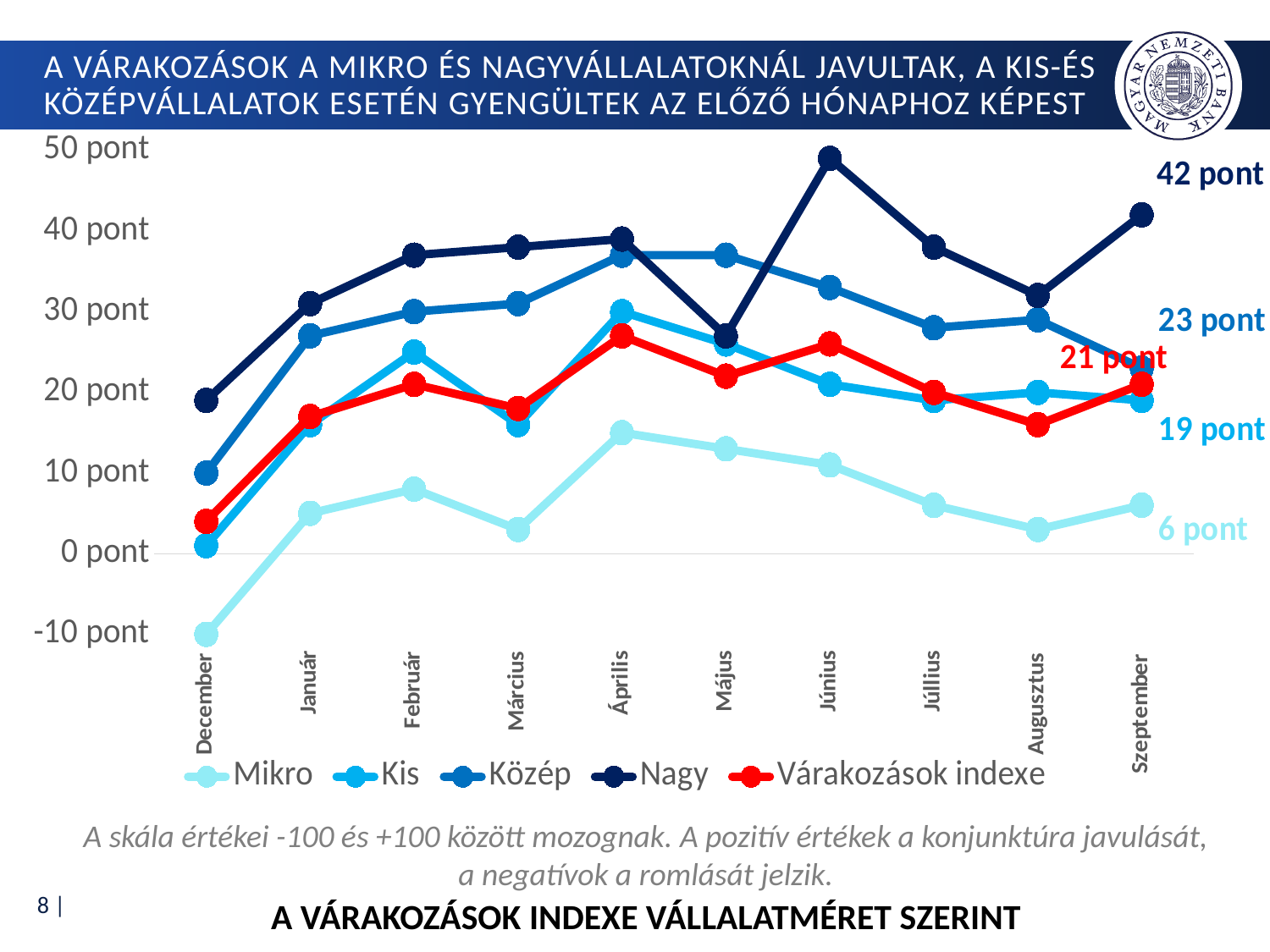
Which series has the highest value in Szeptember? Nagy How many months are shown on the x axis? 10 What is the value for Kis in Szeptember? 19 pont How many series does the legend list? 5 What is the value for Nagy in Szeptember? 42 pont What is the difference between the Nagy and Mikro values in Szeptember? 36 pont What is the value for Közép in Szeptember? 23 pont What is the value of the Várakozások indexe in Szeptember? 21 pont What is the value for Mikro in Szeptember? 6 pont Is the value for Mikro in December greater or less than 0 pont? less What kind of chart is shown on the slide? line chart Is the value for Nagy in Június greater or less than 40 pont? greater